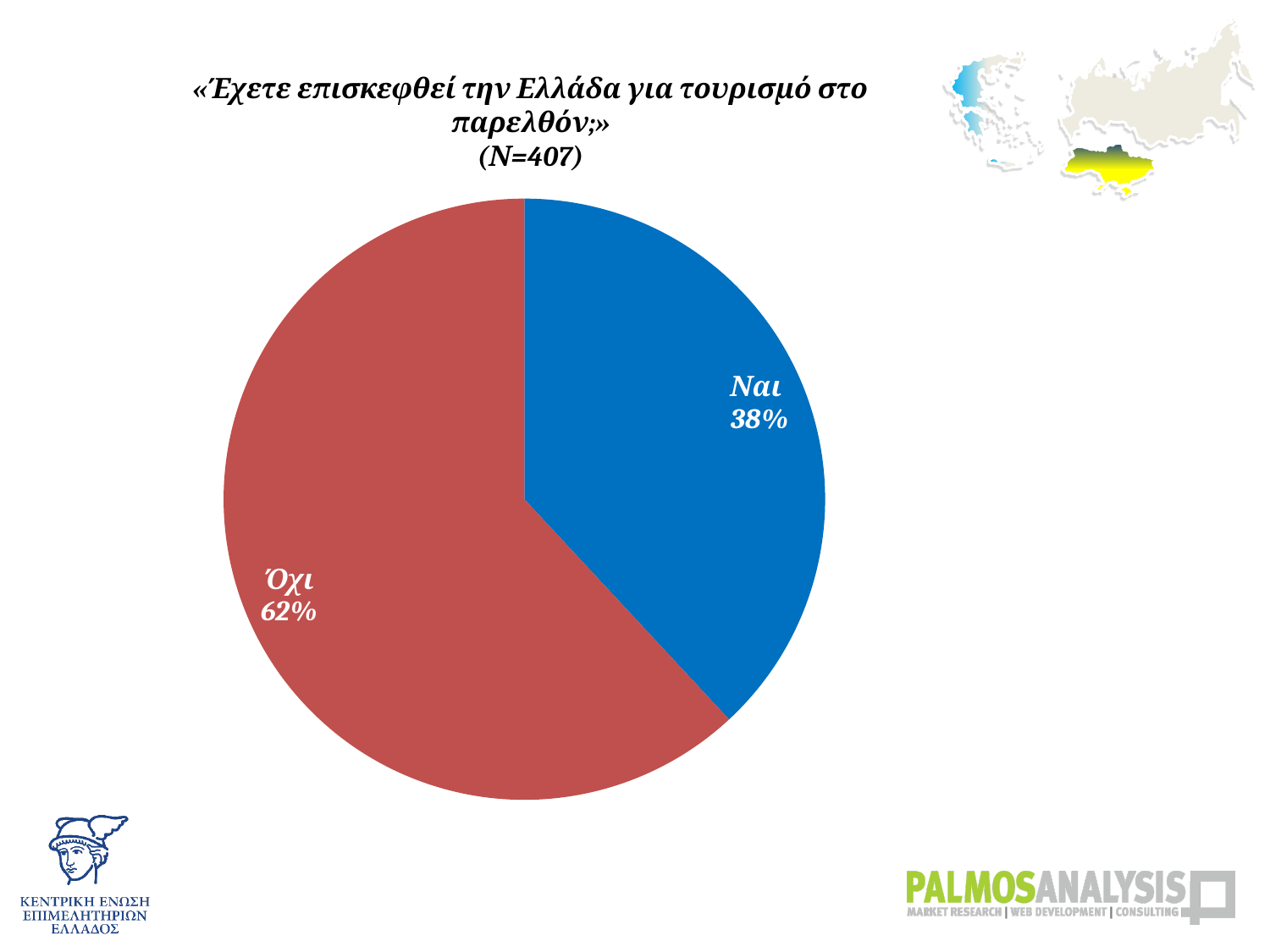
What is the sample size (N) stated in the chart title? 407 What percentage of respondents answered Ναι? 38% How many slices does the pie chart have? 2 Which response has the smallest share of the pie? Ναι What percentage of respondents answered Όχι? 62% Which response has the largest share of the pie? Όχι What kind of chart is shown on the slide? pie chart Which is larger, the share for Ναι or the share for Όχι? Όχι What colour is the Ναι slice? blue Is the share for Ναι greater or less than 50%? less What is the difference in percentage points between Όχι and Ναι? 24